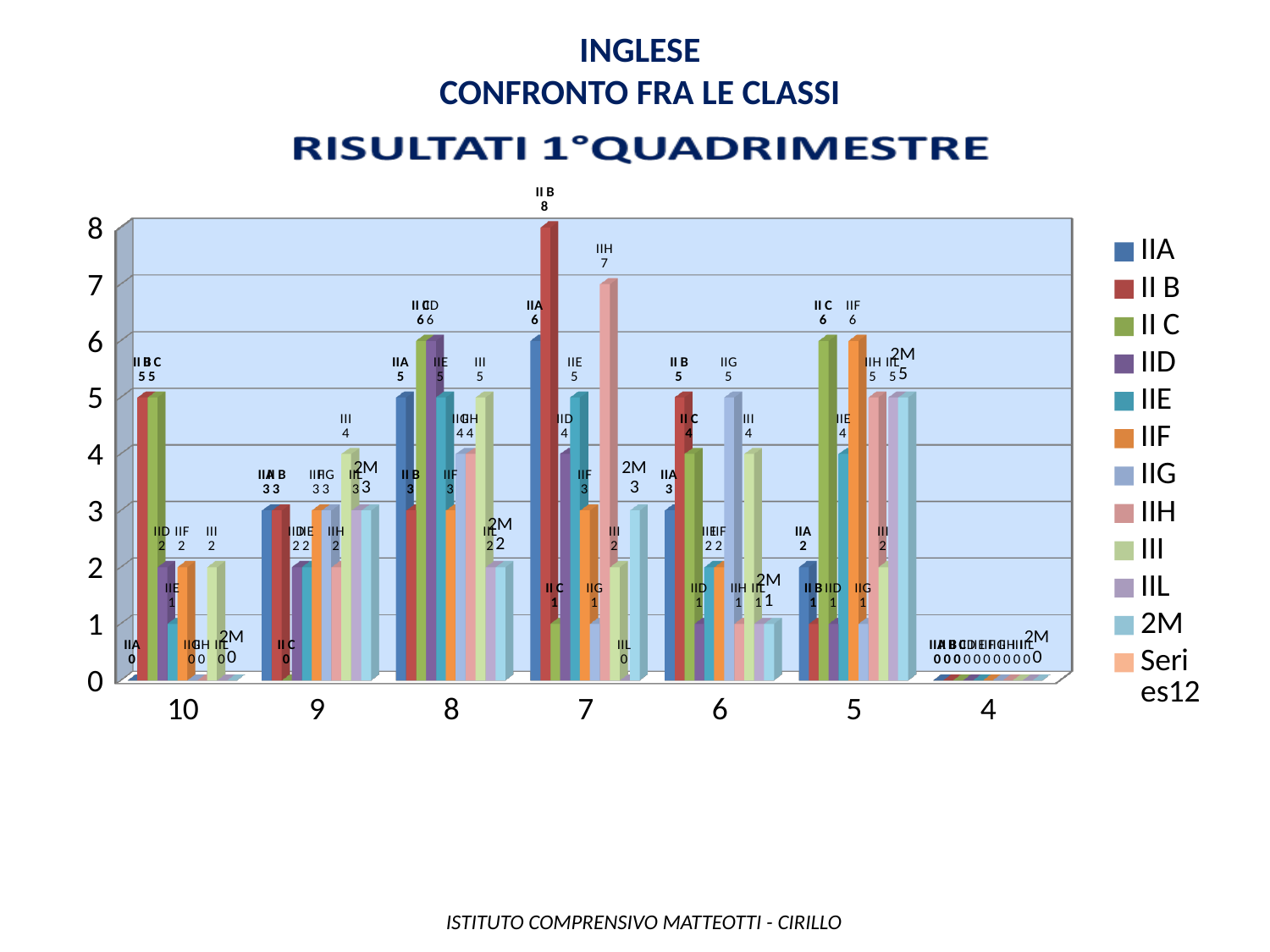
How many categories are shown on the x axis? 7 How many series does the legend list? 12 What is the difference between the II B value and the IIH value in category 7? 1 Which is larger: the IIA value in category 8 or the IIA value in category 6? category 8 What is the value for IIF in category 5? 6 What kind of chart is shown on the slide? bar chart Which series has the lowest value in category 7? IIL What is the title of the chart? RISULTATI 1°QUADRIMESTRE What is the value for IIH in category 7? 7 What is the value for II B in category 7? 8 What is the value for III in category 9? 4 Which series has the highest value in category 7? II B